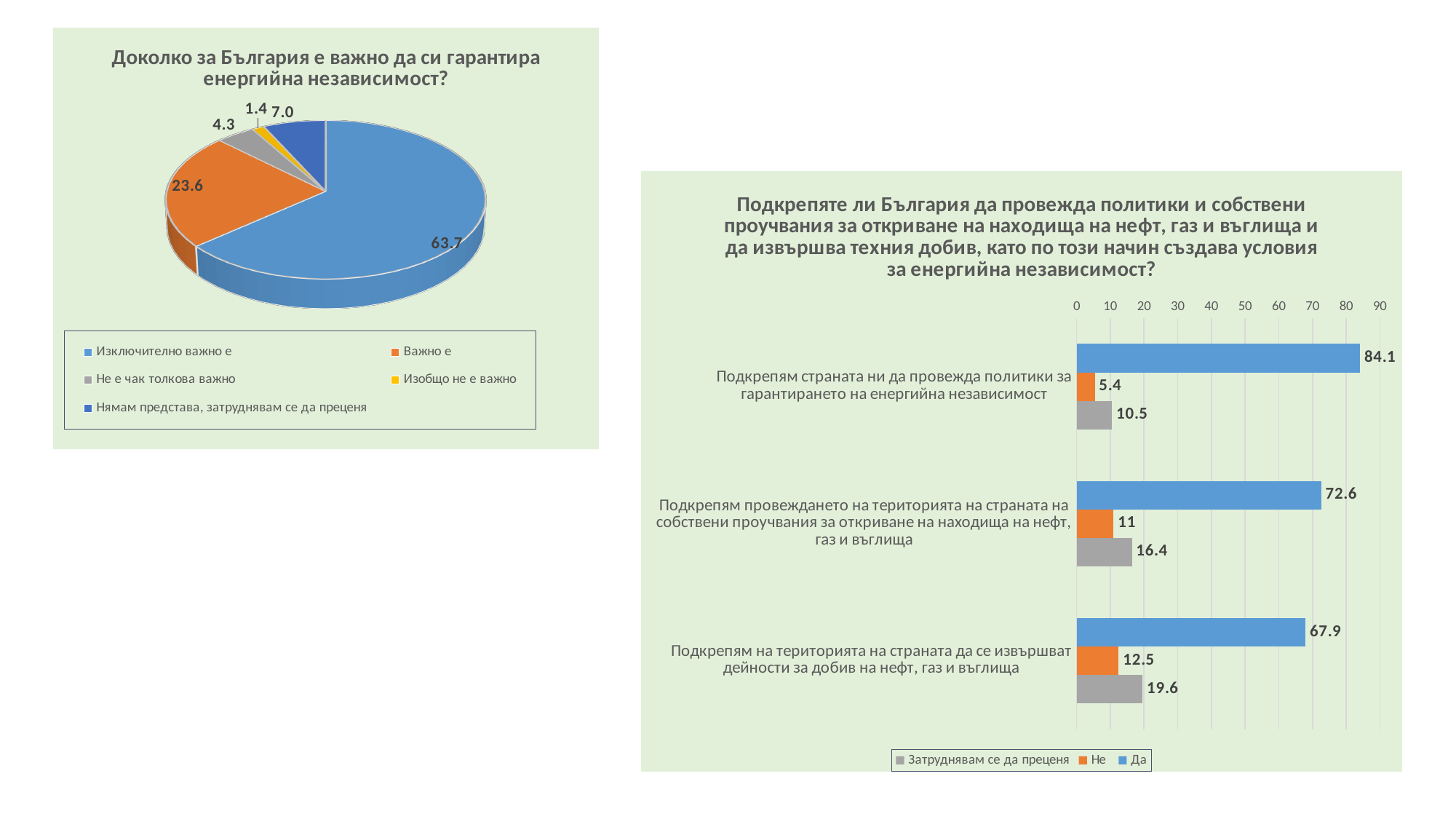
How many series does the legend of the bar chart on the right list? 3 In the bar chart on the right, is the "Затруднявам се да преценя" value larger for "Подкрепям страната ни да провежда политики за гарантирането на енергийна независимост" or for "Подкрепям на територията на страната да се извършват дейности за добив на нефт, газ и въглища"? Подкрепям на територията на страната да се извършват дейности за добив на нефт, газ и въглища What kind of chart is the chart on the left? Pie chart In the pie chart on the left, which category has the smallest slice? Изобщо не е важно In the pie chart on the left, how many slices are there? 5 In the pie chart on the left, what is the difference between the values for "Важно е" and "Нямам представа, затруднявам се да преценя"? 16.6 What kind of chart is the chart on the right? Bar chart In the pie chart on the left, what is the value for "Изключително важно е"? 63.7 In the bar chart on the right, which category has the highest value for "Да"? Подкрепям страната ни да провежда политики за гарантирането на енергийна независимост In the bar chart on the right, what is the difference between the "Да" values for the first category (84.1) and the third category (67.9)? 16.2 In the bar chart on the right, what is the value of "Не" for "Подкрепям провеждането на територията на страната на собствени проучвания за откриване на находища на нефт, газ и въглища"? 11 In the bar chart on the right, what is the value of "Да" for "Подкрепям на територията на страната да се извършват дейности за добив на нефт, газ и въглища"? 67.9